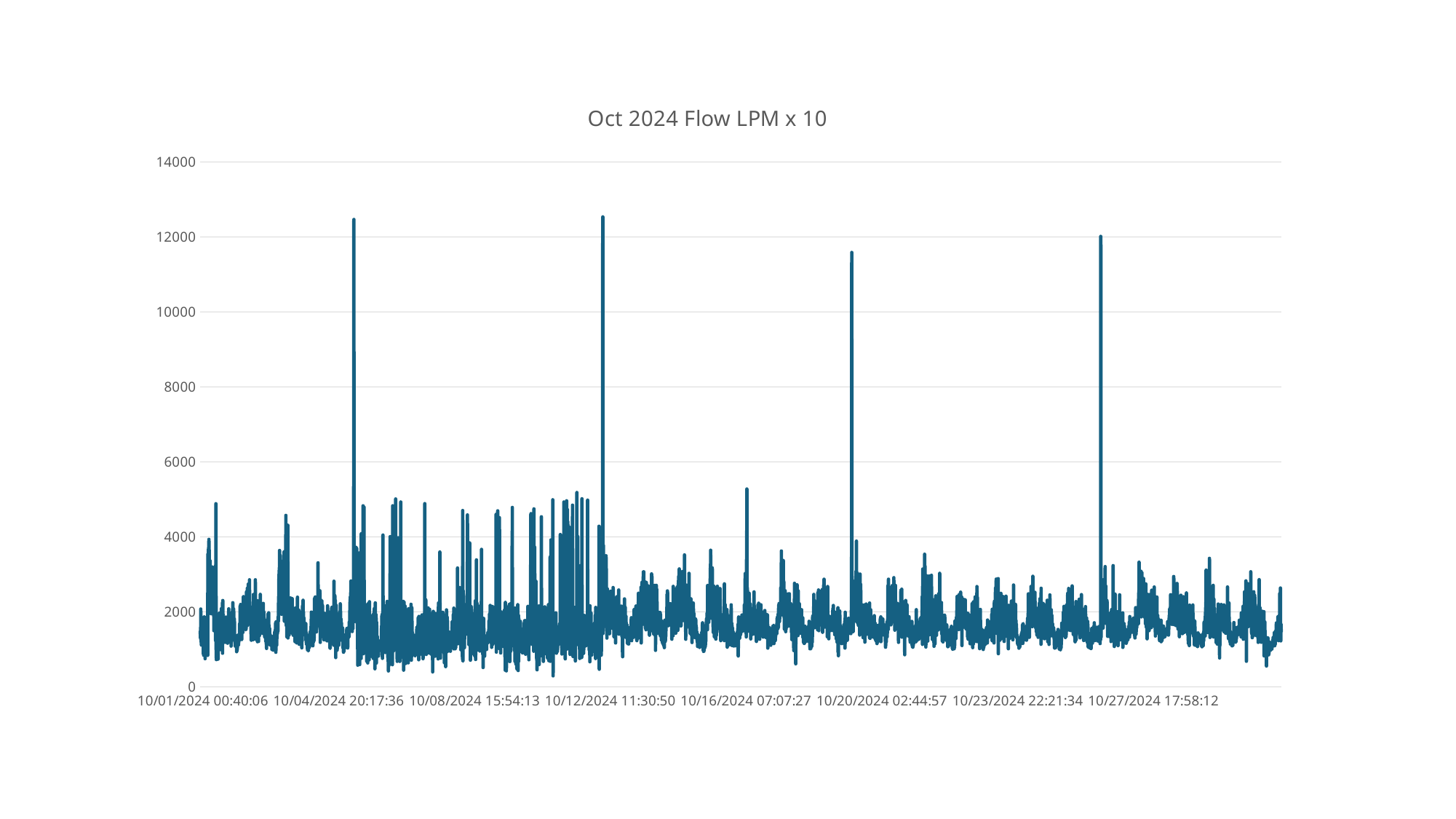
Does the line ever reach 14000? No Is the tallest spike, just after 10/12/2024 11:30:50, greater or less than 12000? greater Which is taller: the spike just after 10/12/2024 11:30:50 or the spike just after 10/20/2024 02:44:57? the spike just after 10/12/2024 11:30:50 How many spikes in the line rise above 10000? 4 What is the highest value labelled on the y axis? 14000 What is the first date label on the x axis? 10/01/2024 00:40:06 What is the title of the chart? Oct 2024 Flow LPM x 10 How many date labels are shown along the x axis? 8 Is the spike shortly after 10/20/2024 02:44:57 greater or less than 12000? less What kind of chart is shown on the slide? line chart